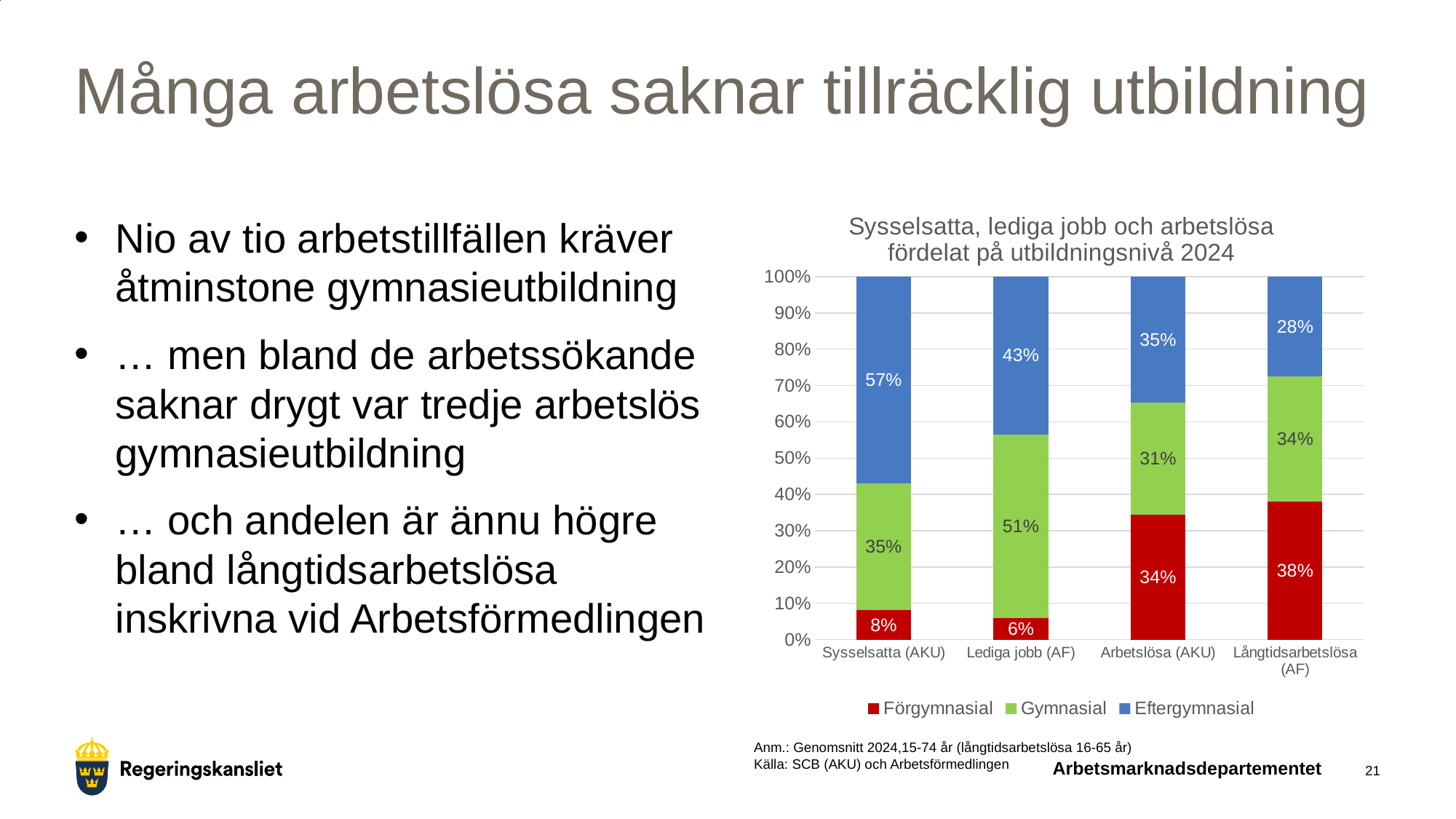
What is the total of the stacked bar for Arbetslösa (AKU)? 100% Which category has the lowest Eftergymnasial share? Långtidsarbetslösa (AF) What is the Eftergymnasial share for Sysselsatta (AKU)? 57% Which category has the highest Förgymnasial share? Långtidsarbetslösa (AF) How many series does the legend list? 3 What is the Förgymnasial share for Långtidsarbetslösa (AF)? 38% What is the title of the chart? Sysselsatta, lediga jobb och arbetslösa fördelat på utbildningsnivå 2024 What is the Gymnasial share for Lediga jobb (AF)? 51% Which is larger: the Gymnasial share for Lediga jobb (AF) or for Arbetslösa (AKU)? Lediga jobb (AF) What is the difference between the Eftergymnasial share for Sysselsatta (AKU) and for Arbetslösa (AKU)? 22 percentage points What kind of chart is shown on the slide? Stacked bar chart How many categories are shown on the x axis? 4